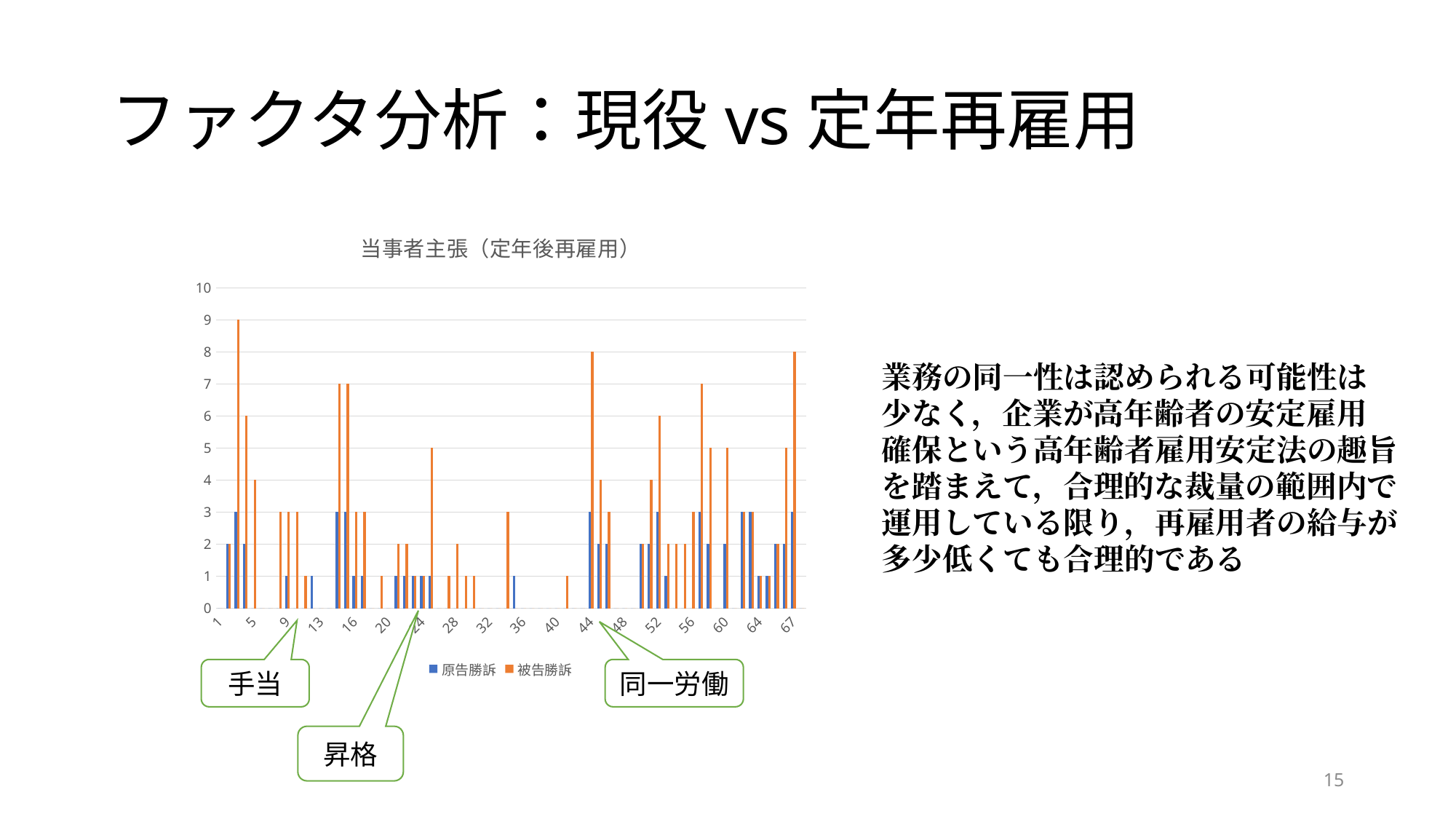
Which series reaches the higher maximum value, 原告勝訴 or 被告勝訴? 被告勝訴 What kind of chart is shown on the slide? bar chart How many series does the legend of the chart list? 2 What is the 被告勝訴 value at category 67? 8 What is the highest value reached by the 原告勝訴 series? 3 What are the two legend entries of the chart? 原告勝訴 and 被告勝訴 Is the tallest 原告勝訴 bar greater or less than 5? less What is the difference between the highest 被告勝訴 value and the highest 原告勝訴 value? 6 Is the tallest 被告勝訴 bar greater or less than 8? greater What is the highest value reached by the 被告勝訴 series? 9 What is the maximum value shown on the vertical axis of the chart? 10